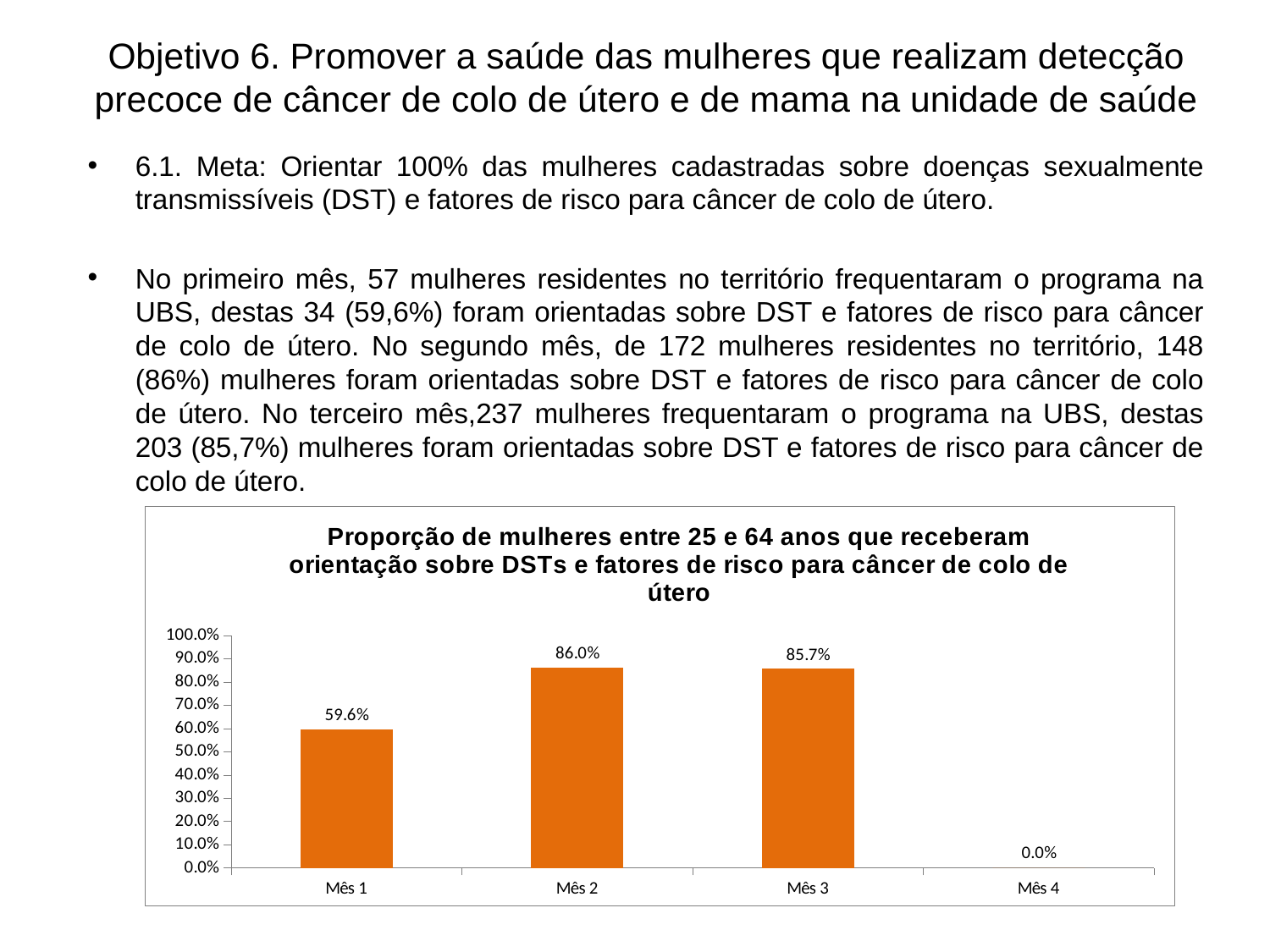
What is the difference between the values for Mês 2 and Mês 1? 26.4% What is the value for Mês 4? 0.0% Is the value for Mês 1 greater or less than 50.0%? greater How many categories are shown on the x axis? 4 What kind of chart is shown on the slide? bar chart What is the value for Mês 1? 59.6% What is the value for Mês 3? 85.7% Which category has the lowest value? Mês 4 What colour are the bars in the chart? orange Which category has the highest value? Mês 2 What is the value for Mês 2? 86.0% Which is larger, the value for Mês 1 or the value for Mês 3? Mês 3